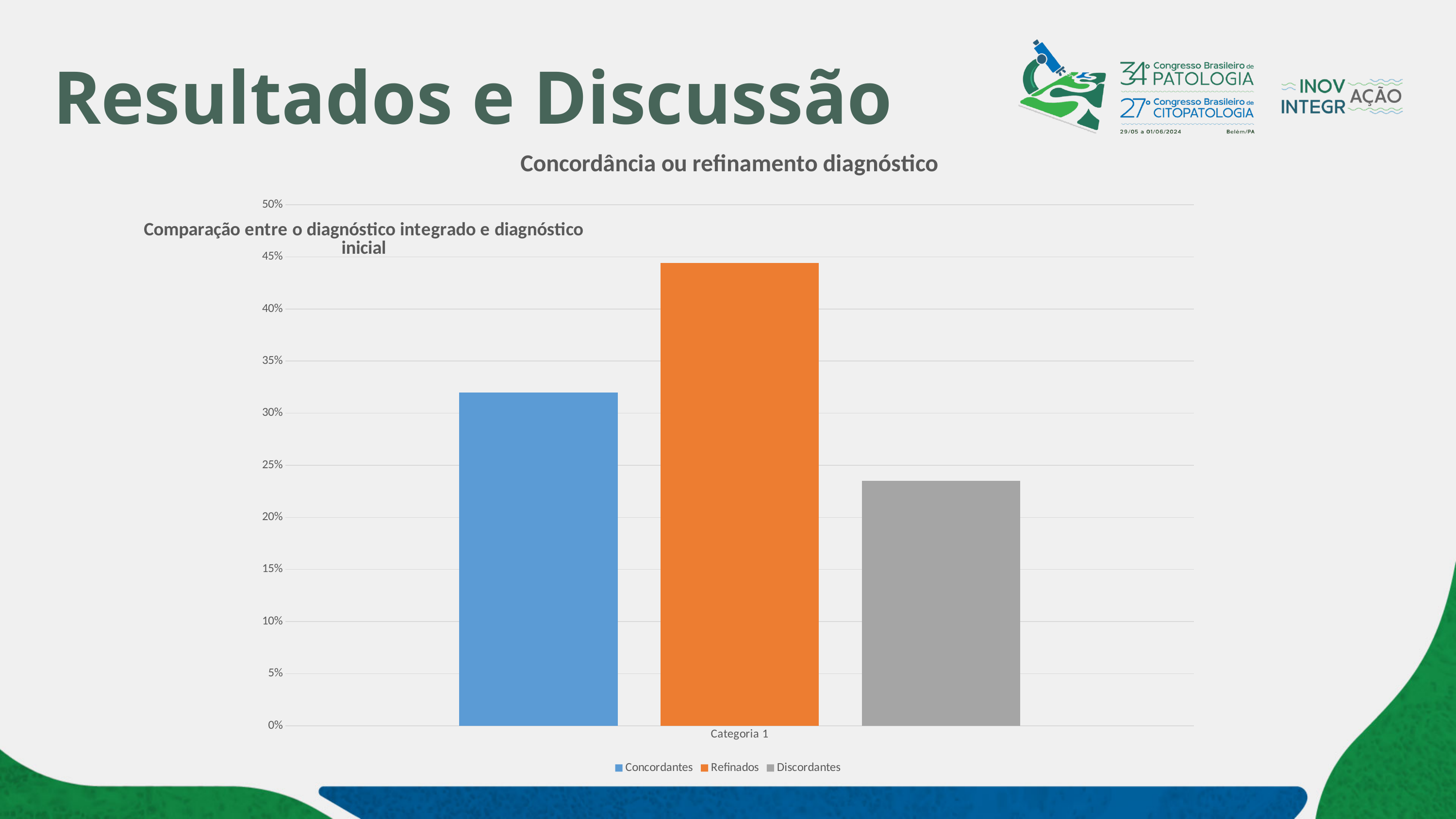
Is the value for Concordantes greater or less than 30%? greater Which is larger, the value for Refinados or the value for Concordantes? Refinados How many series does the legend list? 3 Which is larger, the value for Concordantes or the value for Discordantes? Concordantes Which series has the lowest bar in the chart? Discordantes Is the value for Discordantes greater or less than 25%? less What is the title of the chart? Concordância ou refinamento diagnóstico Which series has the highest bar in the chart? Refinados What colour is the bar for Refinados? orange Is the value for Refinados greater or less than 40%? greater What kind of chart is shown on the slide? bar chart